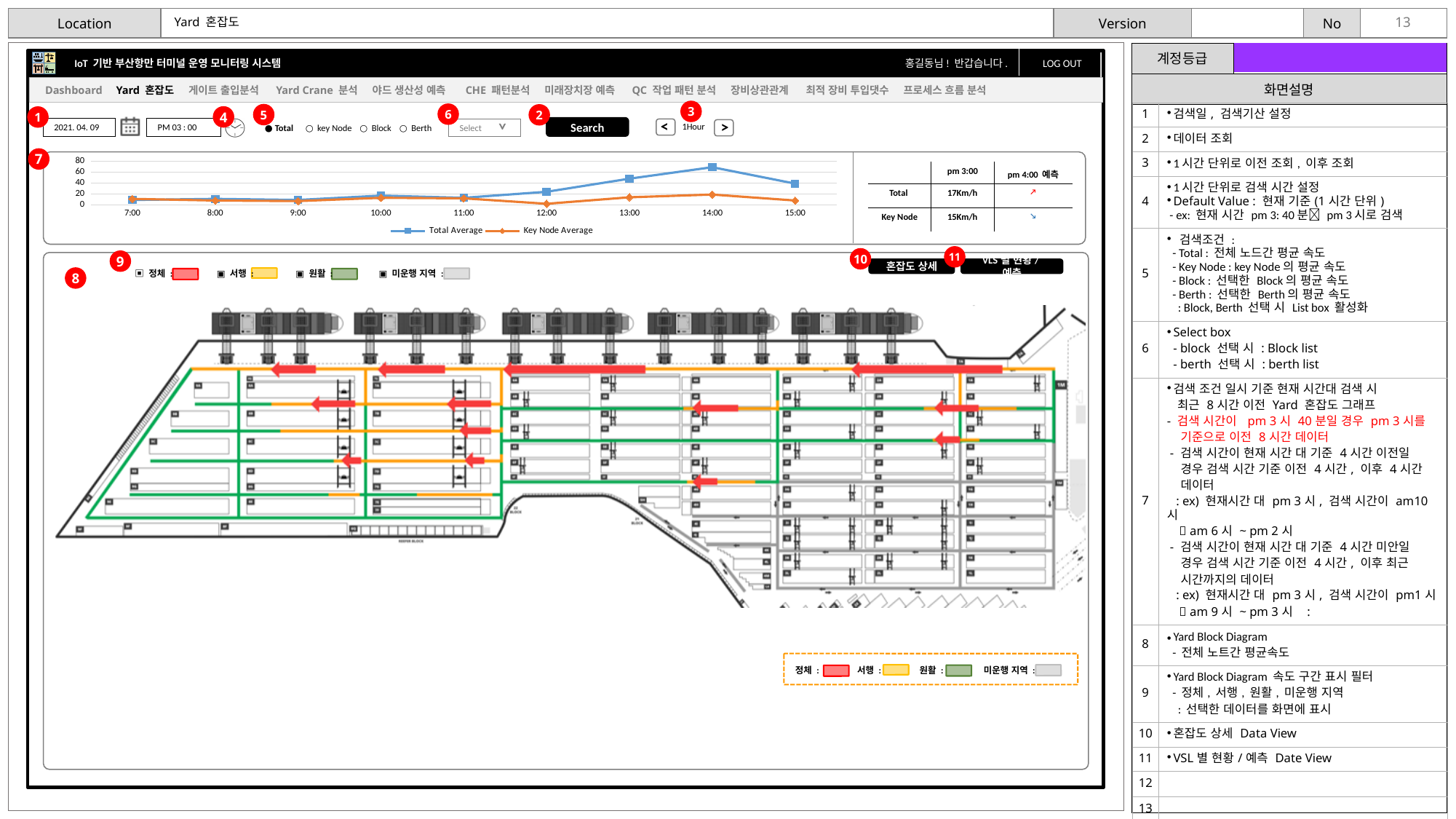
Is the Total Average value at 13:00 greater or less than 40? greater At 14:00, which series has the larger value, Total Average or Key Node Average? Total Average What kind of chart is shown at the top of the slide? line chart Is the Key Node Average value at 14:00 greater or less than 40? less Does the Total Average series rise or fall between 12:00 and 14:00? rise How many time points are shown along the x axis of the line chart? 9 How many series does the legend of the line chart list? 2 Does the Total Average series rise or fall between 14:00 and 15:00? fall What are the two series named in the line chart's legend? Total Average and Key Node Average Is the Total Average value at 14:00 greater or less than 60? greater At which time does the Total Average series reach its highest value? 14:00